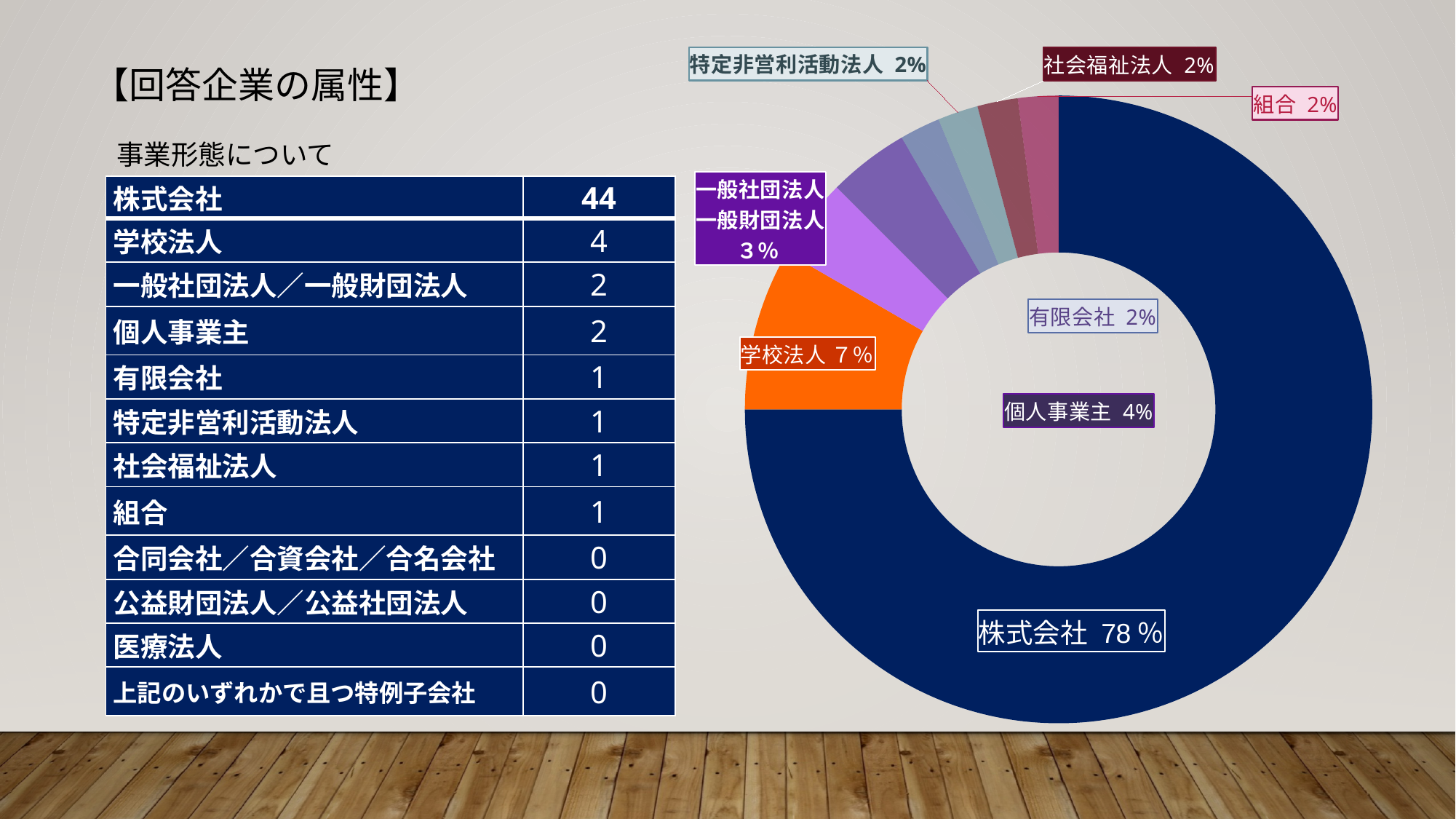
What colour is the 学校法人 slice in the pie chart? Orange What percentage is shown for 学校法人 in the pie chart? 7% What is the difference in percentage points between 株式会社 and 学校法人 in the pie chart? 71 Which category has the largest slice in the pie chart? 株式会社 How many labeled slices does the pie chart have? 8 What percentage is shown for 一般社団法人／一般財団法人 in the pie chart? 3% What percentage is shown for 社会福祉法人 in the pie chart? 2% What share of the pie chart does 株式会社 represent? 78% Which slice is larger in the pie chart, 学校法人 or 個人事業主? 学校法人 What type of chart is shown on the slide? Pie (donut) chart What percentage is shown for 有限会社 in the pie chart? 2% What percentage is shown for 個人事業主 in the pie chart? 4%